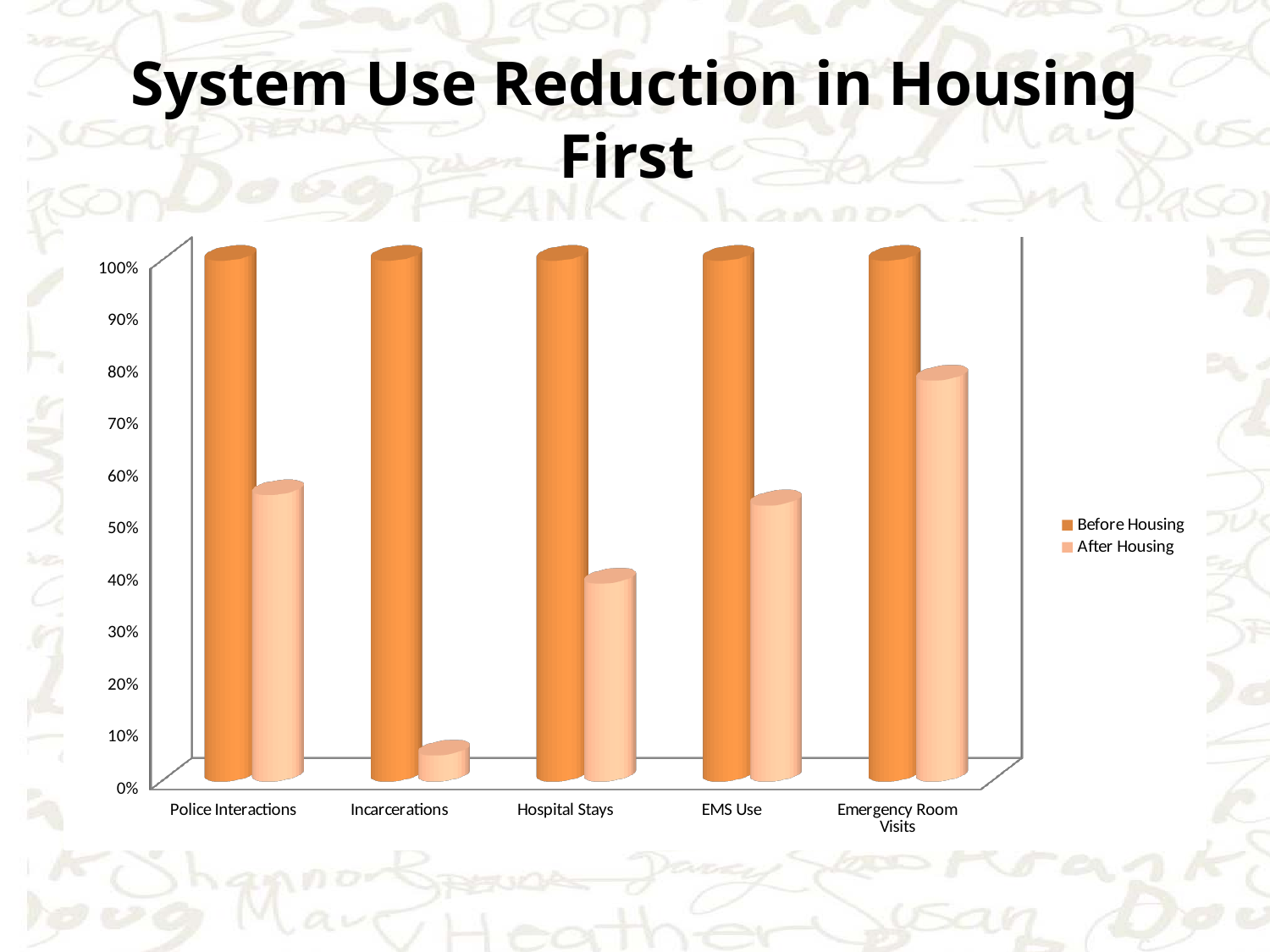
How many series does the chart's legend list? 2 What is the title of the chart on the slide? System Use Reduction in Housing First Is the After Housing value for Hospital Stays greater or less than 50%? less Which is larger: the After Housing value for Police Interactions or for Hospital Stays? Police Interactions Is the After Housing value for Incarcerations greater or less than 10%? less What are the two series named in the legend? Before Housing and After Housing What kind of chart is shown on the slide? Bar chart Which category has the lowest After Housing value? Incarcerations Which category has the highest After Housing value? Emergency Room Visits How many categories are shown on the x axis of the chart? 5 Is the After Housing value for Police Interactions greater or less than 50%? greater